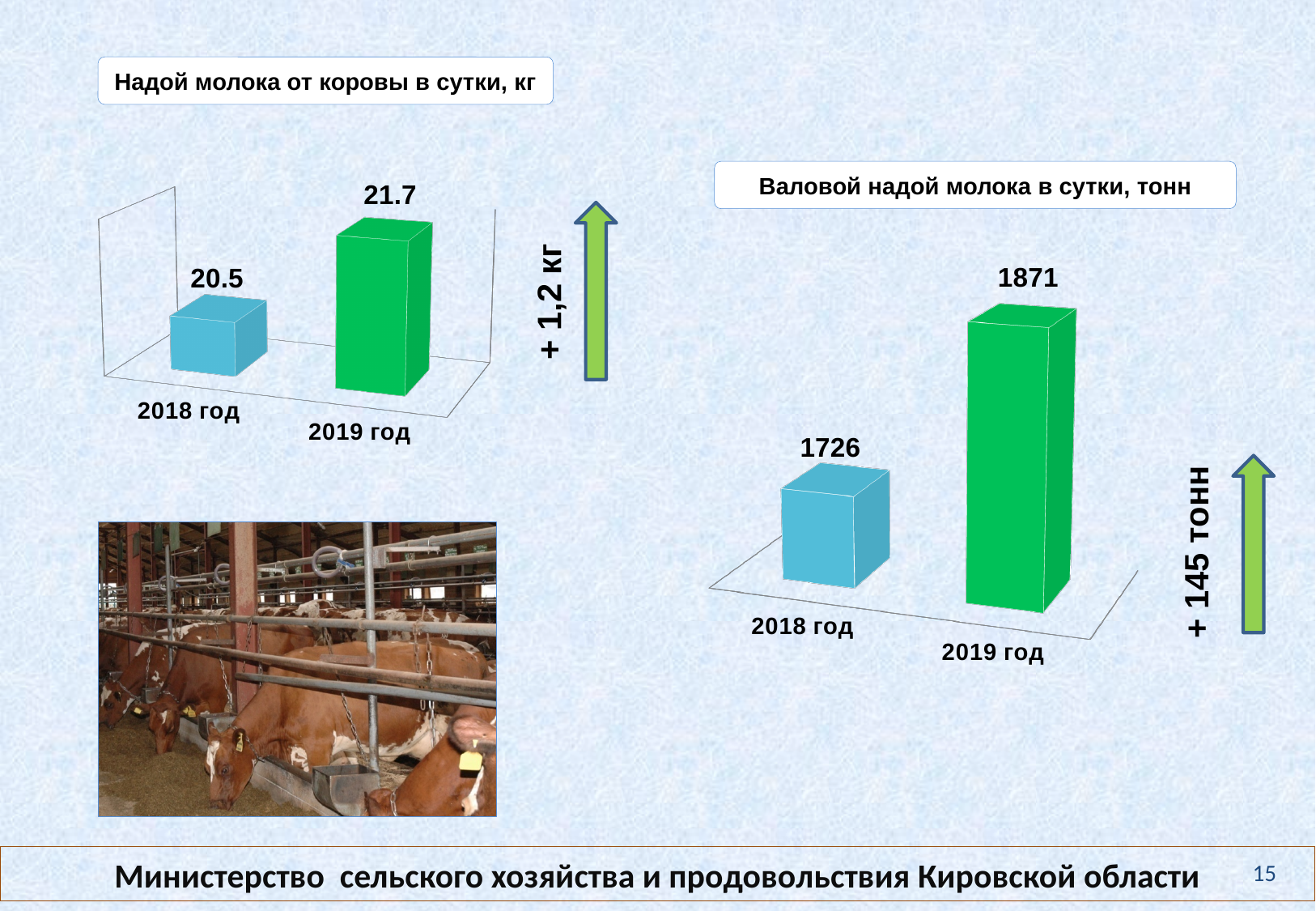
In the chart titled "Валовой надой молока в сутки, тонн", which year has the lower value? 2018 год In the chart titled "Надой молока от коровы в сутки, кг", what is the value for 2019 год? 21.7 In the chart titled "Надой молока от коровы в сутки, кг", what is the difference between the 2019 год and 2018 год values? 1.2 In the chart titled "Валовой надой молока в сутки, тонн", what is the value for 2019 год? 1871 How many categories are shown in the chart titled "Надой молока от коровы в сутки, кг"? 2 In the chart titled "Валовой надой молока в сутки, тонн", what is the value for 2018 год? 1726 In the chart titled "Надой молока от коровы в сутки, кг", what is the value for 2018 год? 20.5 In the chart titled "Надой молока от коровы в сутки, кг", do the values rise or fall from 2018 год to 2019 год? rise In the chart titled "Валовой надой молока в сутки, тонн", what is the difference between the 2019 год and 2018 год values? 145 In the chart titled "Валовой надой молока в сутки, тонн", is the value for 2018 год larger or smaller than the value for 2019 год? smaller In the chart titled "Надой молока от коровы в сутки, кг", which year has the higher value? 2019 год What kind of chart is the chart titled "Валовой надой молока в сутки, тонн"? bar chart